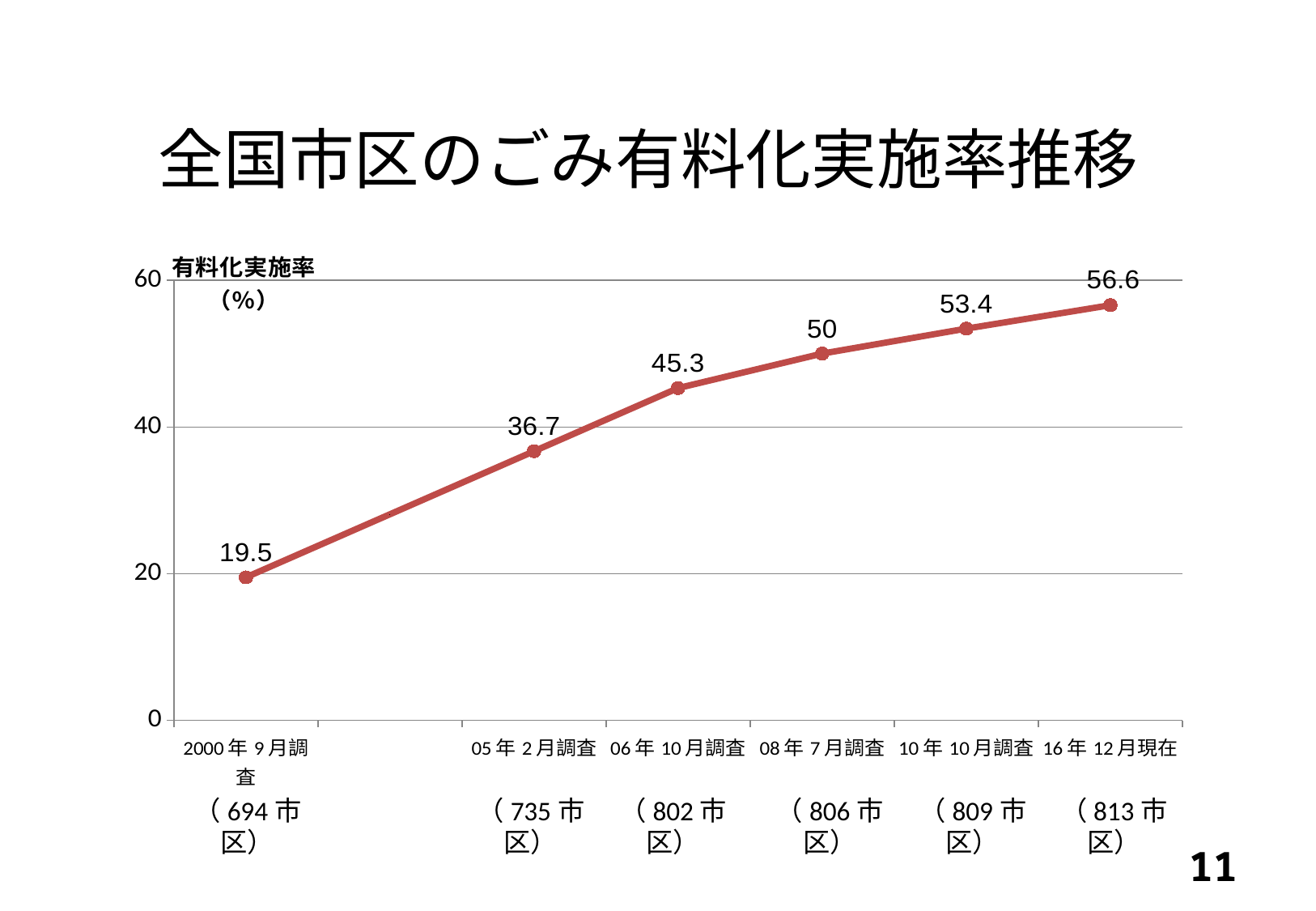
What is the value for 06年10月調査 (802市区)? 45.3 Do the values rise or fall from left to right along the x axis? rise What is the value for 16年12月現在 (813市区)? 56.6 Which survey point has the lowest value? 2000年9月調査 (694市区) Is the value for 05年2月調査 greater or less than 40? less What is the difference between the values for 08年7月調査 and 05年2月調査? 13.3 What kind of chart is shown on the slide? line chart What is the value for 2000年9月調査 (694市区)? 19.5 Which is larger, the value for 10年10月調査 or the value for 06年10月調査? 10年10月調査 How many data points are plotted on the line? 6 Which survey point has the highest value? 16年12月現在 (813市区) What is the difference between the values for 16年12月現在 and 2000年9月調査? 37.1